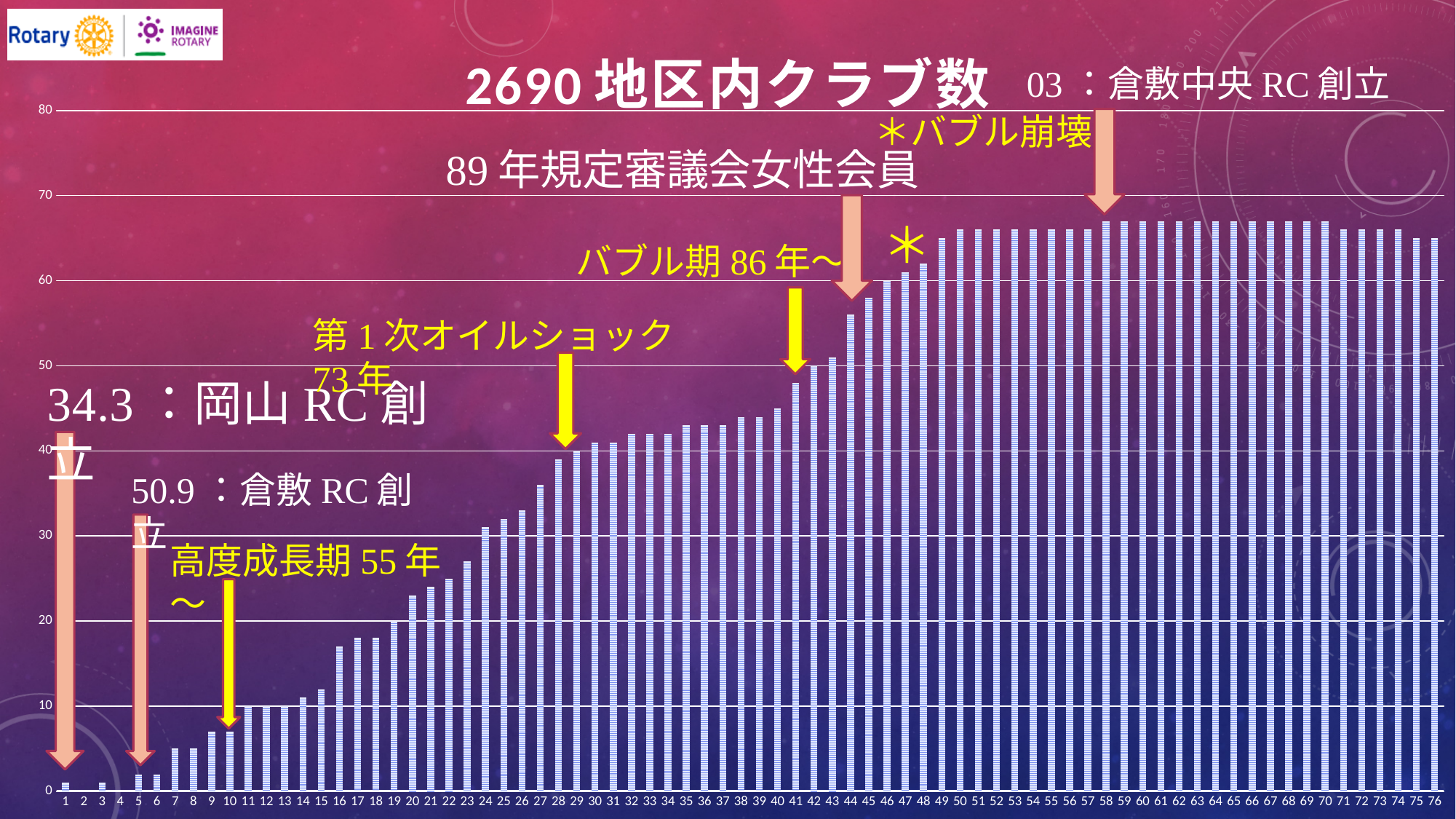
Is the value for category 10 greater or less than 10? less Is the value for category 50 greater or less than 60? greater Is the value for category 36 greater or less than 50? less Which has the larger value, category 28 or category 44? category 44 What is the title of the chart? 2690 地区内クラブ数 What kind of chart is shown on the slide? bar chart Which has the larger value, category 10 or category 20? category 20 How many categories are shown along the x axis of the chart? 76 Do the bar values generally rise or fall from category 1 to category 50? rise